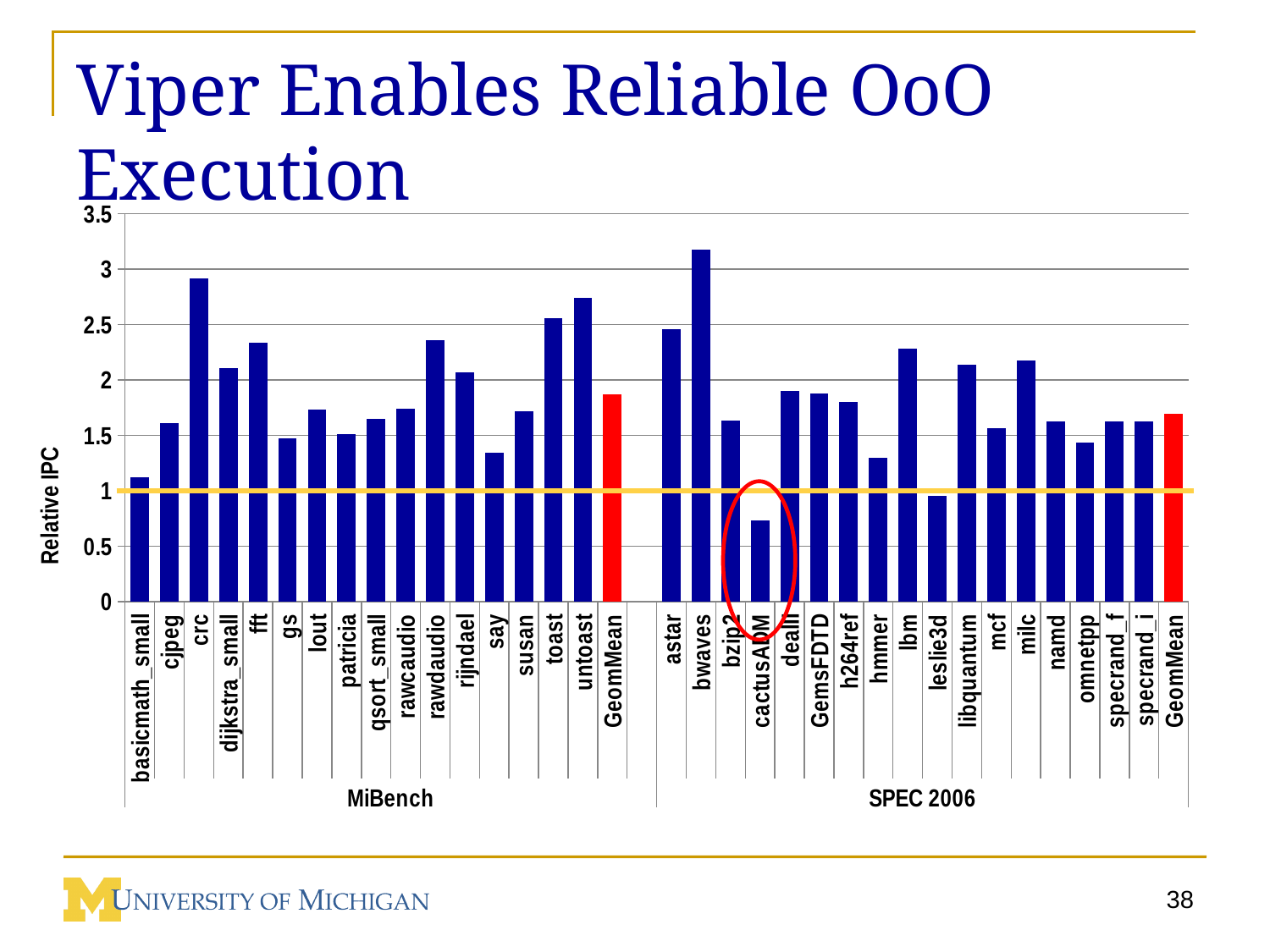
What is the label on the y axis of the chart? Relative IPC Is the relative IPC for untoast greater or less than 2.5? greater Within the MiBench group, which benchmark has the lowest relative IPC? basicmath_small Which benchmark has the lowest relative IPC across the whole chart? cactusADM How many benchmark bars (including GeomMean bars) are plotted in the SPEC 2006 group? 18 Within the MiBench group, which benchmark has the highest relative IPC? crc Is the relative IPC for hmmer greater or less than 1.5? less Which has the higher relative IPC, toast or untoast? untoast What kind of chart is shown on the slide? bar chart Is the relative IPC for bwaves greater or less than 3? greater Which benchmark has the highest relative IPC across the whole chart? bwaves